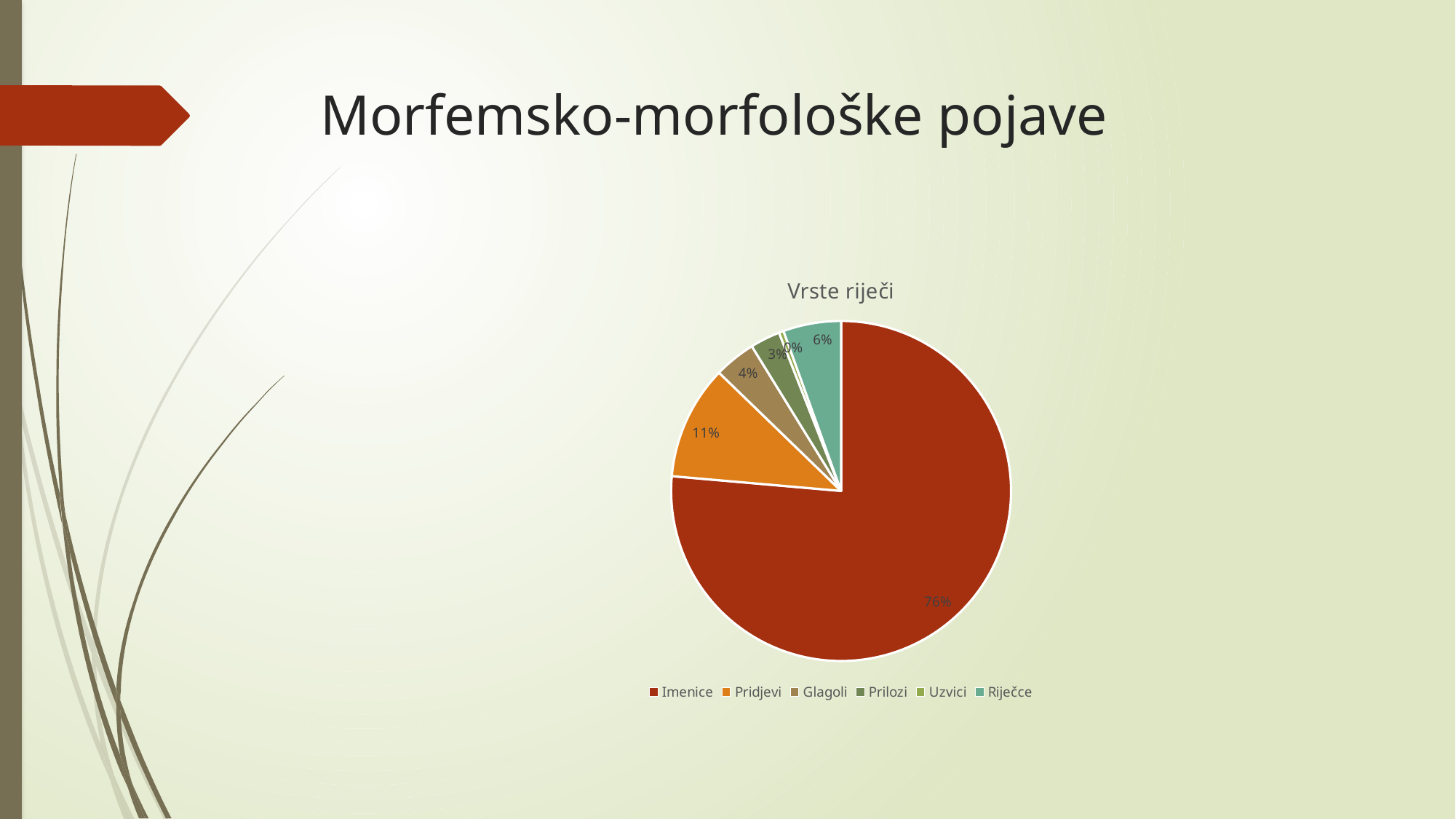
What share of the pie does Prilozi have? 3% Which category has the smallest slice of the pie? Uzvici What share of the pie does Imenice have? 76% How many categories does the legend list? 6 What is the difference between the shares of Imenice and Pridjevi? 65% What is the title of the chart? Vrste riječi What share of the pie does Glagoli have? 4% What type of chart is shown on the slide? pie chart Which category has the largest slice of the pie? Imenice Which is larger, the share for Riječce or the share for Glagoli? Riječce